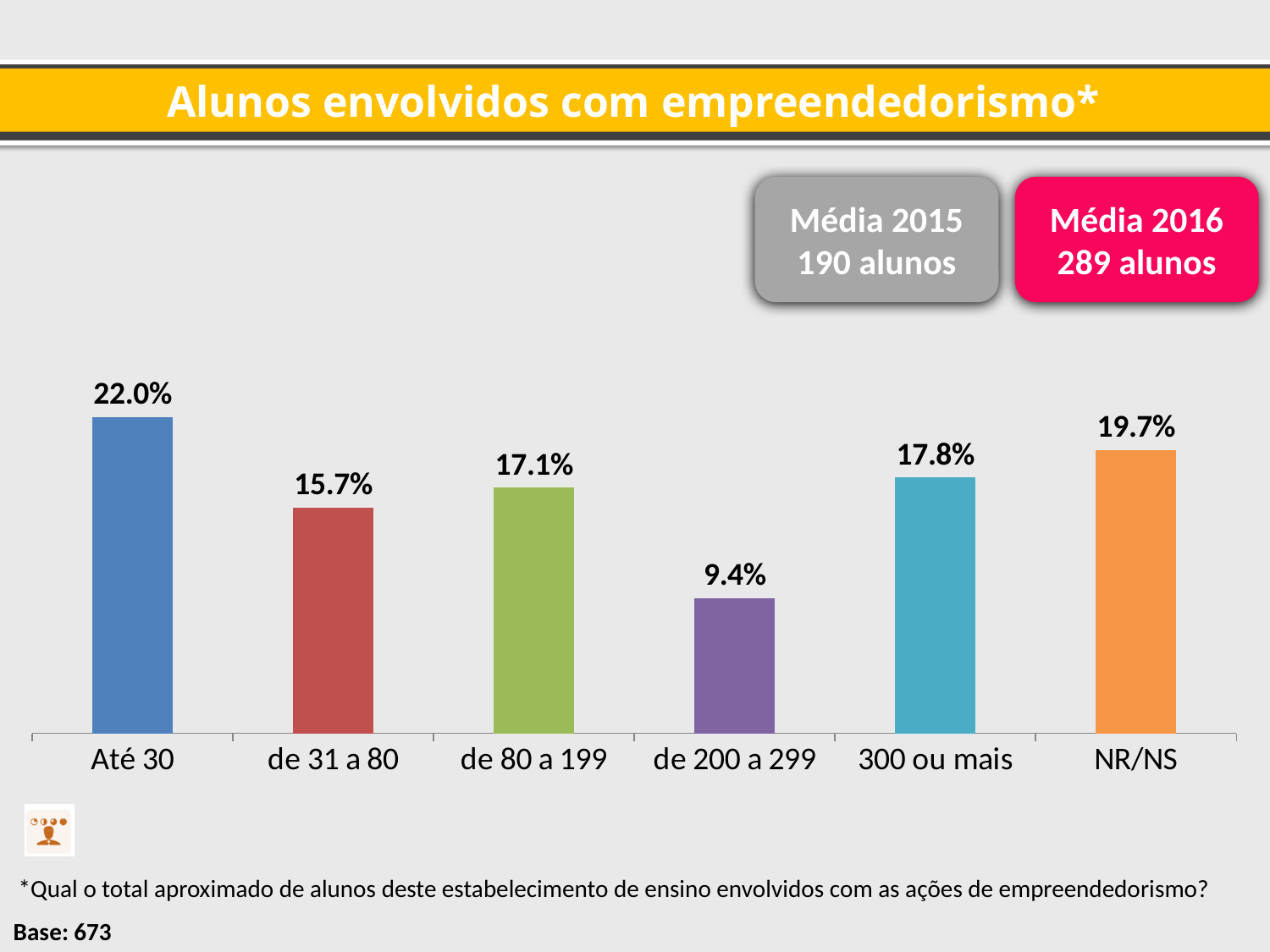
Which is larger, the value for 'de 80 a 199' or the value for 'de 31 a 80'? de 80 a 199 What is the value for the 'NR/NS' category? 19.7% What is the value for the '300 ou mais' category? 17.8% What is the difference between the values for 'Até 30' and 'de 200 a 299'? 12.6% What is the difference between the values for 'NR/NS' and 'de 31 a 80'? 4.0% What is the value for the 'de 200 a 299' category? 9.4% What kind of chart is shown on the slide? Bar chart Which category has the lowest value? de 200 a 299 What is the value for the 'Até 30' category? 22.0% What is the title of the chart? Alunos envolvidos com empreendedorismo* Which category has the highest value? Até 30 How many categories are shown on the x axis? 6